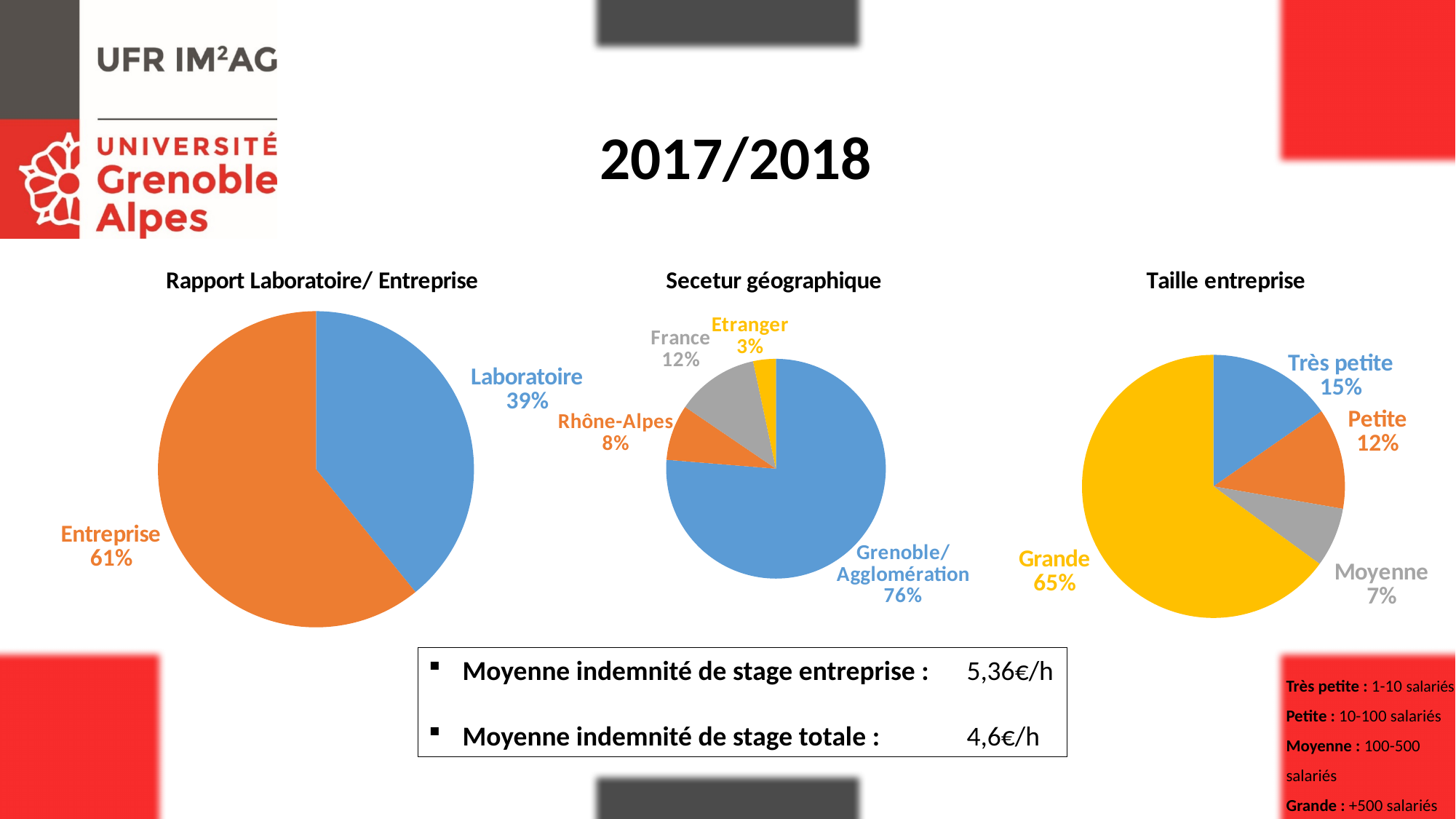
In the 'Secetur géographique' chart, which is larger, France or Rhône-Alpes? France How many pie charts are shown on the slide? 3 In the 'Secetur géographique' chart, which category has the smallest share? Etranger In the 'Secetur géographique' chart, how many categories are shown? 4 In the 'Secetur géographique' chart, what share does Grenoble/Agglomération have? 76% What type of chart is the 'Taille entreprise' chart? Pie chart In the 'Rapport Laboratoire/ Entreprise' chart, what share does Entreprise have? 61% In the 'Taille entreprise' chart, what is the difference between the Très petite and Petite shares? 3% In the 'Taille entreprise' chart, which category has the smallest share? Moyenne In the 'Taille entreprise' chart, what share does Grande have? 65% In the 'Rapport Laboratoire/ Entreprise' chart, what share does Laboratoire have? 39% In the 'Rapport Laboratoire/ Entreprise' chart, what is the difference between the Entreprise and Laboratoire shares? 22%